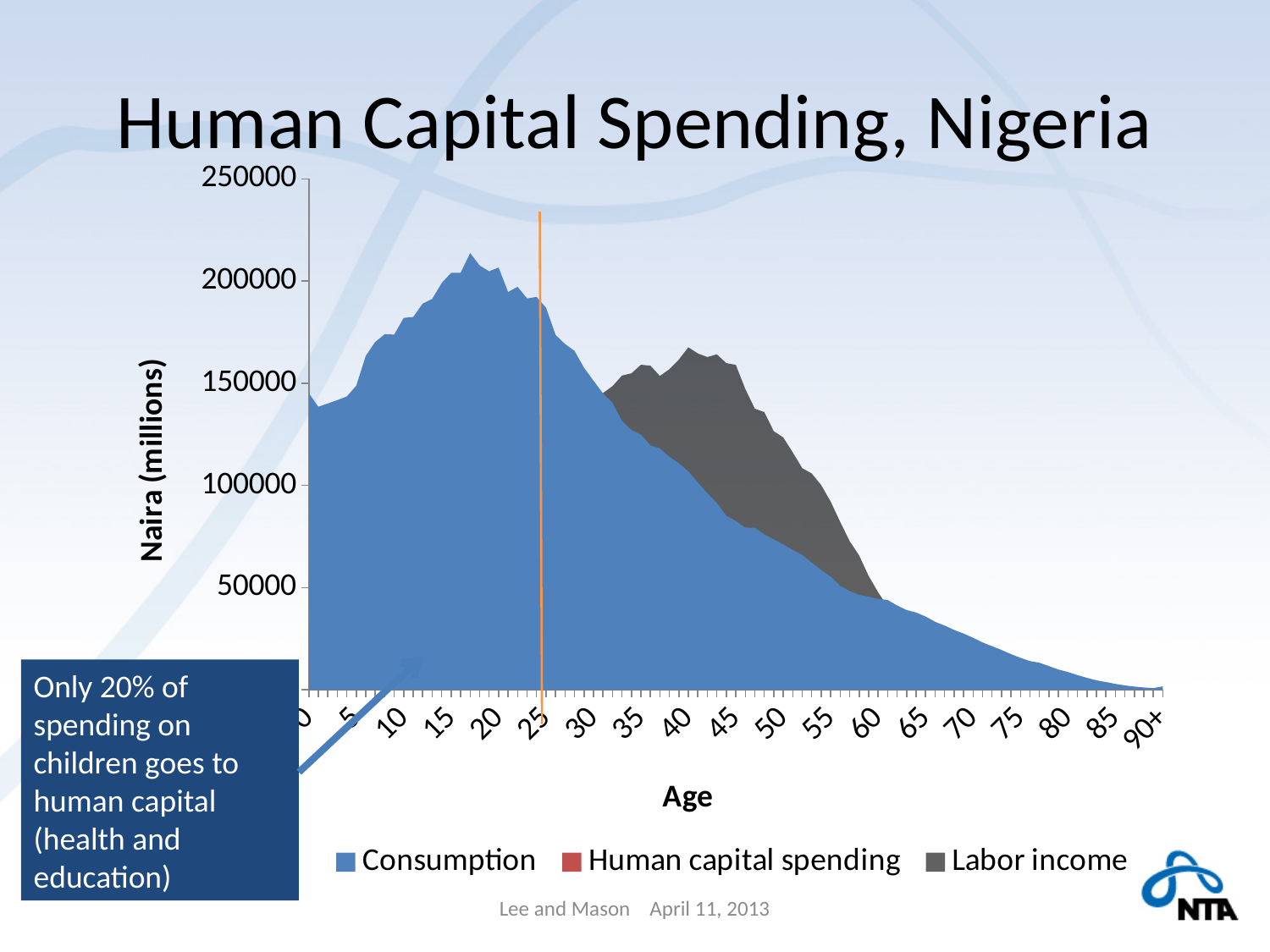
Is the Consumption value at age 10 greater or less than 150000? greater At age 40, which is larger: Consumption or Labor income? Labor income Is the Consumption value at age 70 greater or less than 50000? less Is the Consumption value at age 80 greater or less than 50000? less What is the label of the vertical axis? Naira (millions) Does Consumption rise or fall along the age axis from age 30 to age 90+? Fall How many series does the legend list? 3 What is the title of the chart? Human Capital Spending, Nigeria What kind of chart is shown on the slide? Area chart Does Consumption rise or fall along the age axis from age 5 to age 15? Rise